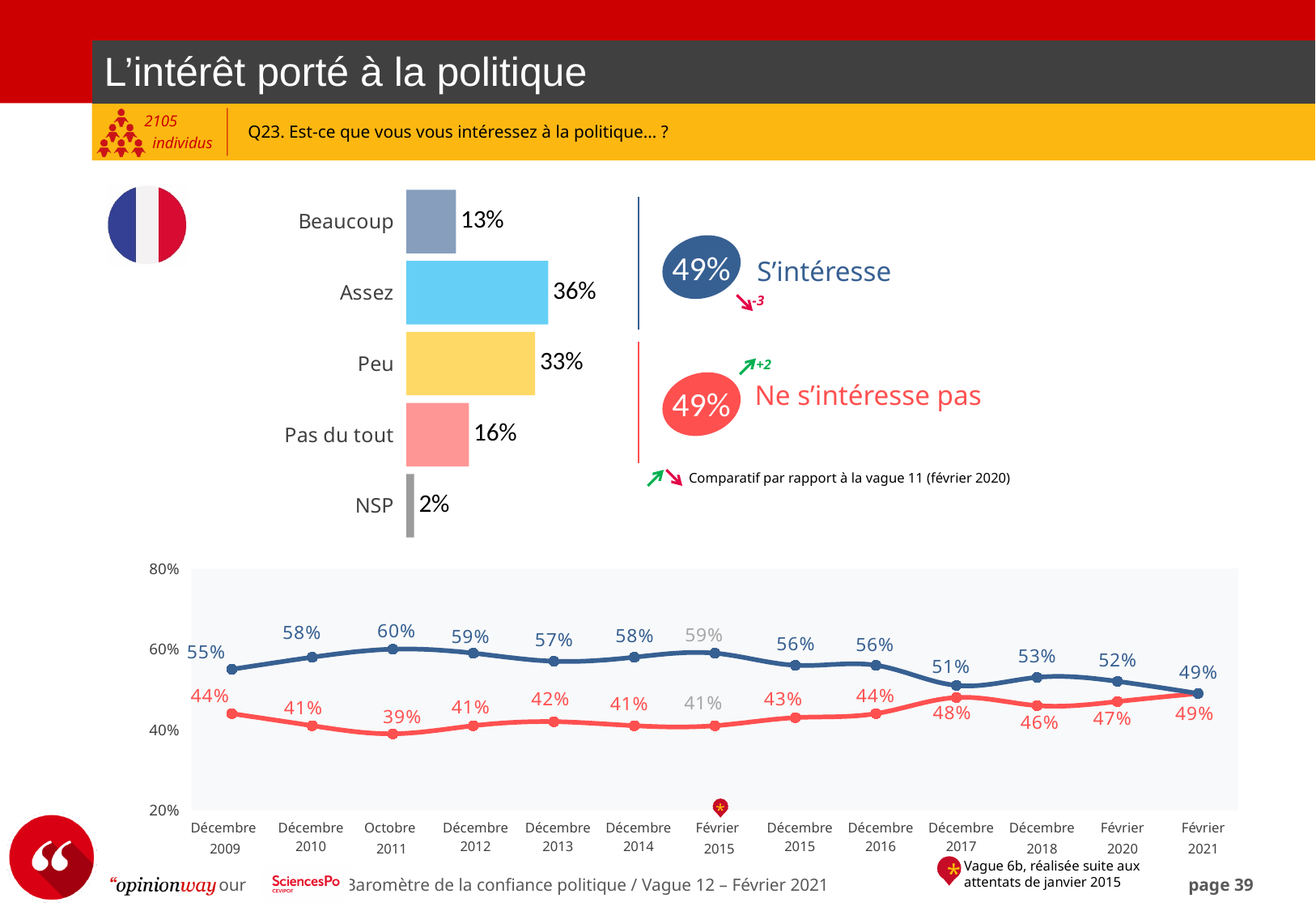
In the top bar chart, how many categories are shown? 5 In the top bar chart, what percentage is shown for 'Pas du tout'? 16% In the top bar chart, which category has the highest value? Assez In the bottom line chart, how many time points are plotted on the x axis? 13 In the bottom line chart, what is the value of the blue line in Octobre 2011? 60% What type of chart is the top chart on the slide? Bar chart In the top bar chart, what is the difference between the values for 'Assez' and 'Peu'? 3% In the top bar chart, which category has the lowest value? NSP In the bottom line chart, does the blue line rise or fall between Décembre 2016 and Février 2021? Fall In the bottom line chart, what is the value of the red line in Décembre 2017? 48% In the bottom line chart, what is the difference between the blue and red values in Décembre 2009? 11% In the top bar chart, what percentage is shown for 'Assez'? 36%